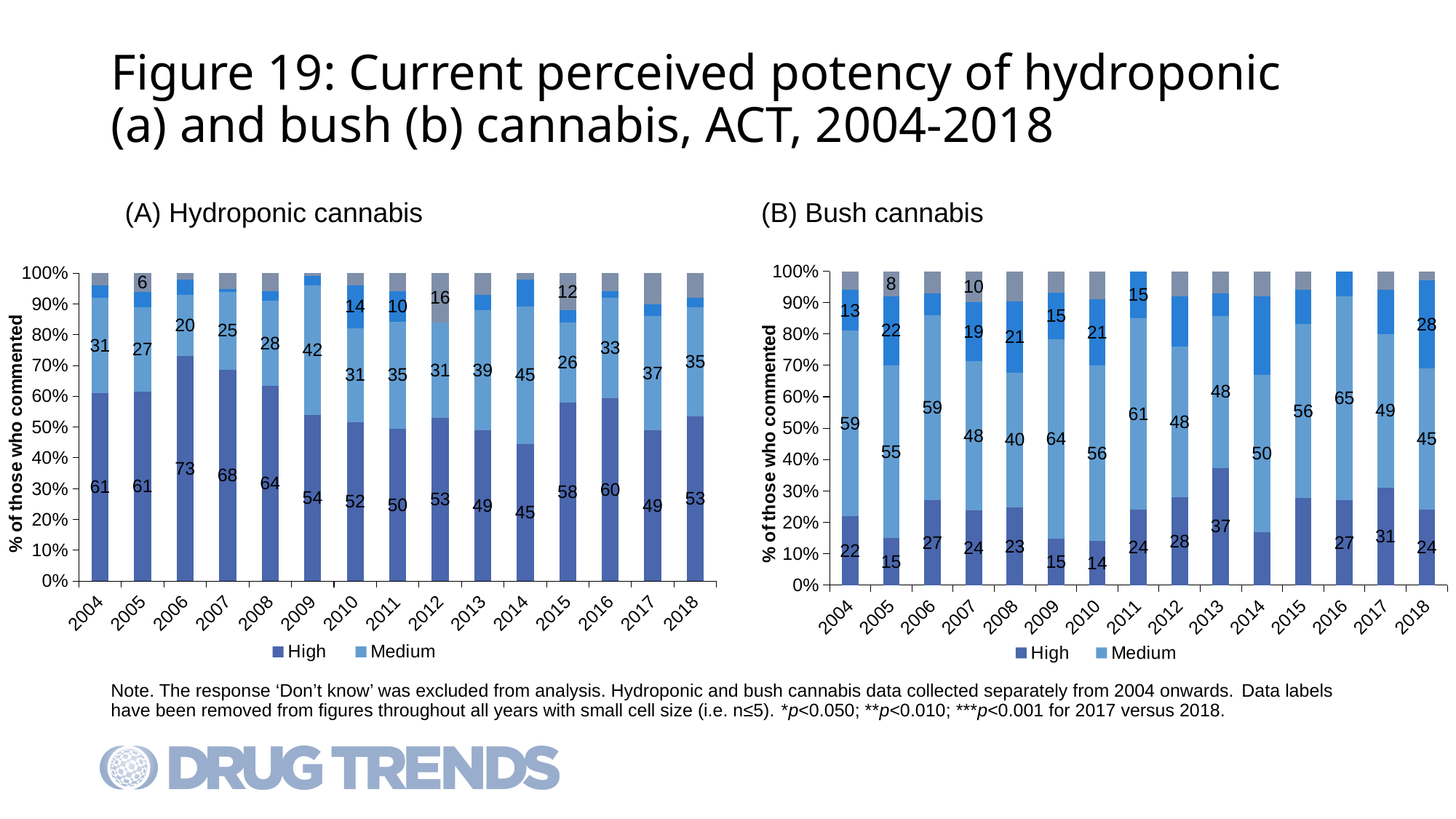
In chart (A) Hydroponic cannabis, what percentage rated potency as High in 2006? 73 How many years are shown on the x axis of chart (B) Bush cannabis? 15 In chart (B) Bush cannabis, which year has the highest High value? 2013 In chart (A) Hydroponic cannabis, does the High value generally rise or fall from 2006 to 2014? fall How many series does the legend of chart (A) Hydroponic cannabis list? 2 What kind of chart is chart (A) Hydroponic cannabis? Stacked bar chart In chart (A) Hydroponic cannabis, which year has the lowest High value? 2014 In chart (B) Bush cannabis, is the High value for 2014 greater or less than 20%? less In chart (A) Hydroponic cannabis, which year has the highest High value? 2006 In chart (B) Bush cannabis, what is the Medium value for 2016? 65 In chart (A) Hydroponic cannabis, what is the difference between the High value in 2006 and the High value in 2014? 28 In chart (A) Hydroponic cannabis, which is larger: the Medium value for 2009 or the Medium value for 2008? 2009